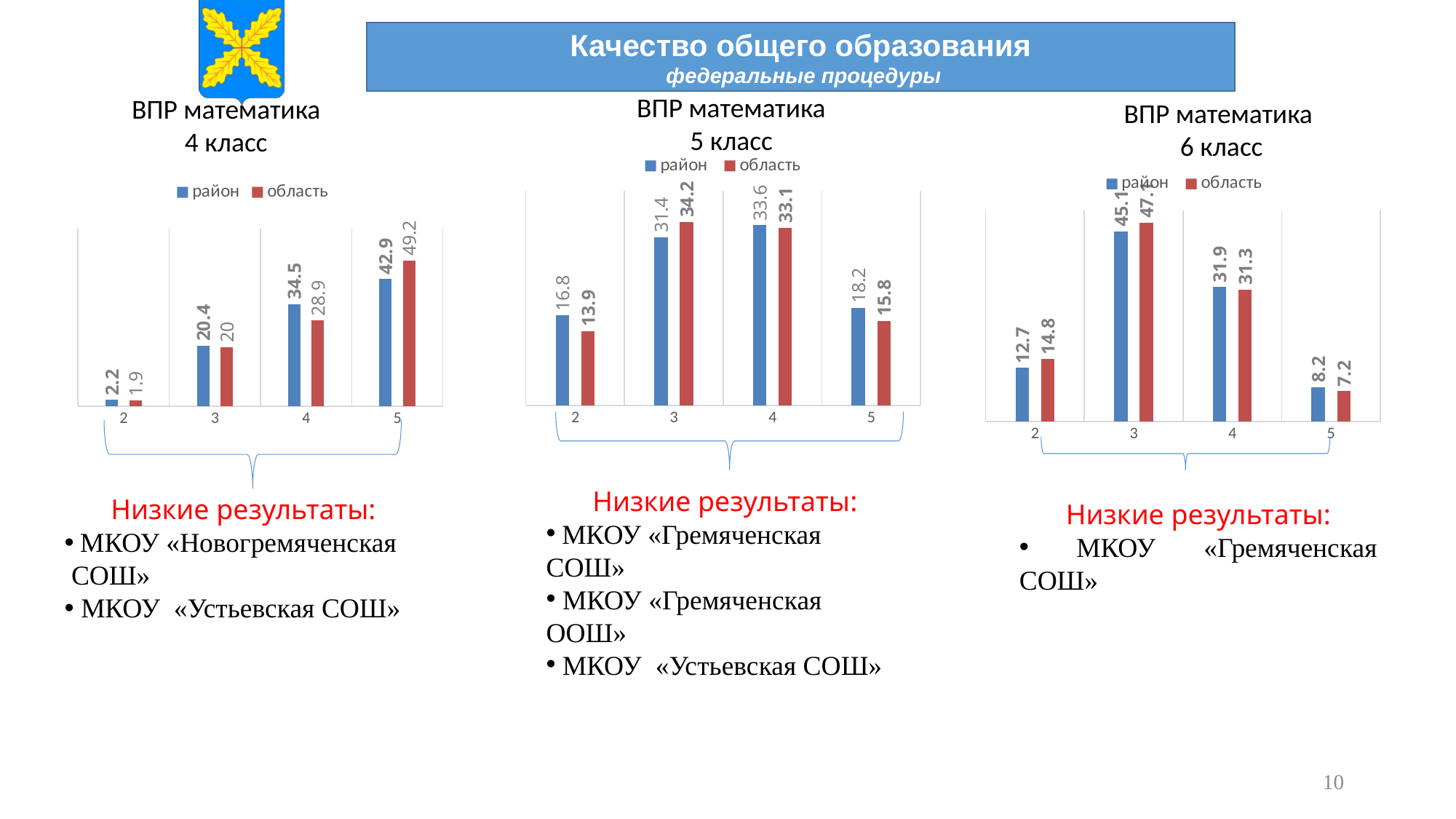
In the 'ВПР математика 5 класс' chart, what is the value for область at category 2? 13.9 In the 'ВПР математика 5 класс' chart, which is larger at category 3: район or область? область In the 'ВПР математика 6 класс' chart, what is the difference between район and область at category 5? 1 In the 'ВПР математика 4 класс' chart, what is the difference between область and район at category 5? 6.3 What kind of chart is the 'ВПР математика 5 класс' chart? bar chart In the 'ВПР математика 6 класс' chart, what is the value for район at category 3? 45.1 How many series does the legend of the 'ВПР математика 6 класс' chart list? 2 In the 'ВПР математика 6 класс' chart, which category has the lowest value for область? 5 In the 'ВПР математика 4 класс' chart, what is the value for район at category 5? 42.9 In the 'ВПР математика 4 класс' chart, which category has the lowest value for район? 2 In the 'ВПР математика 5 класс' chart, which category has the highest value for район? 4 In the 'ВПР математика 4 класс' chart, what is the value for область at category 4? 28.9